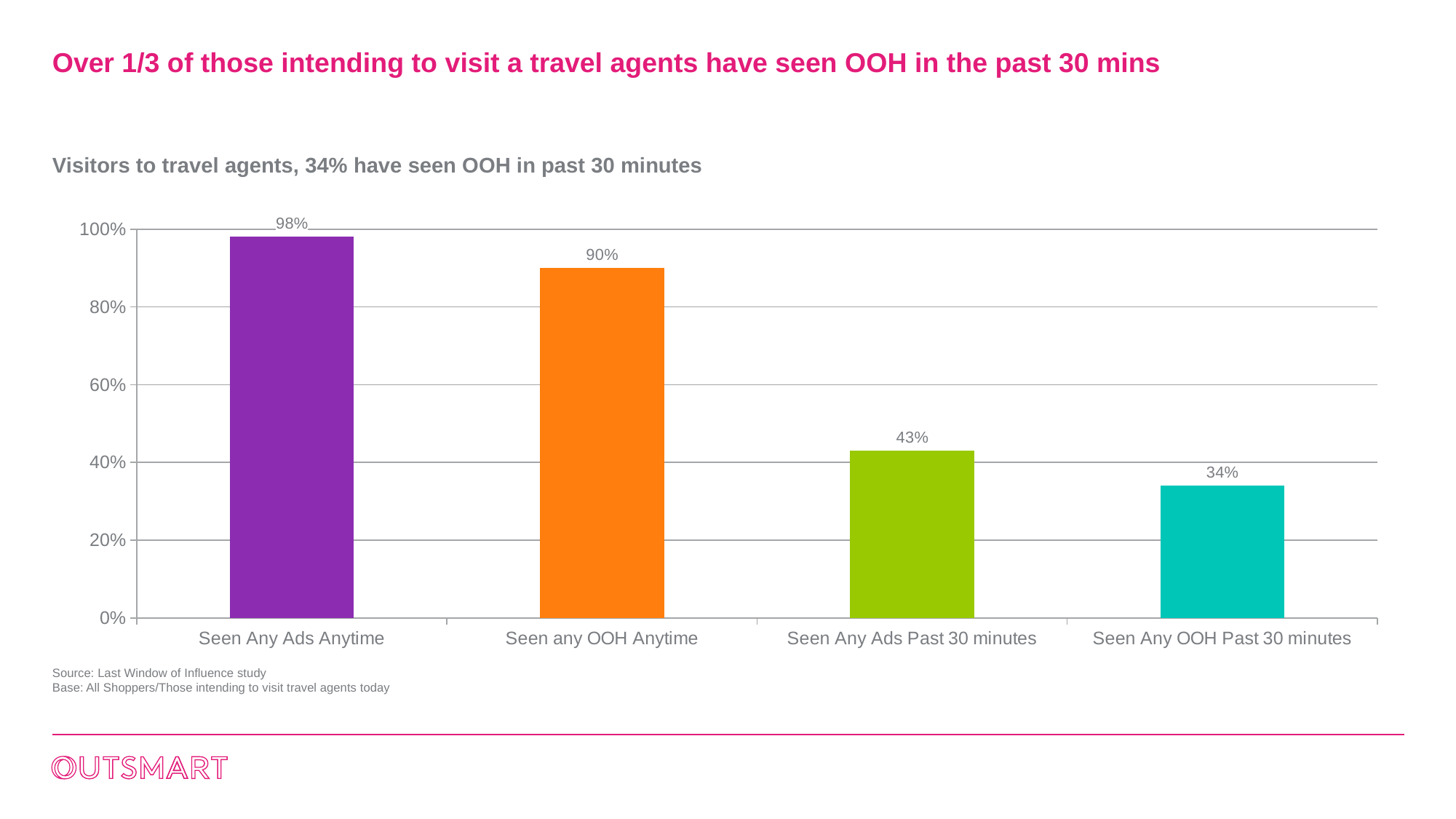
What is the difference between Seen Any Ads Anytime and Seen any OOH Anytime? 8% Which is larger, Seen any OOH Anytime or Seen Any Ads Past 30 minutes? Seen any OOH Anytime How many categories are shown in the chart? 4 Is the value for Seen Any OOH Past 30 minutes greater or less than 40%? less What is the value for Seen Any OOH Past 30 minutes? 34% What is the value for Seen Any Ads Anytime? 98% What is the value for Seen Any Ads Past 30 minutes? 43% Which category has the lowest value? Seen Any OOH Past 30 minutes Which category has the highest value? Seen Any Ads Anytime What is the difference between Seen Any Ads Past 30 minutes and Seen Any OOH Past 30 minutes? 9% What kind of chart is shown on the slide? Bar chart What is the value for Seen any OOH Anytime? 90%